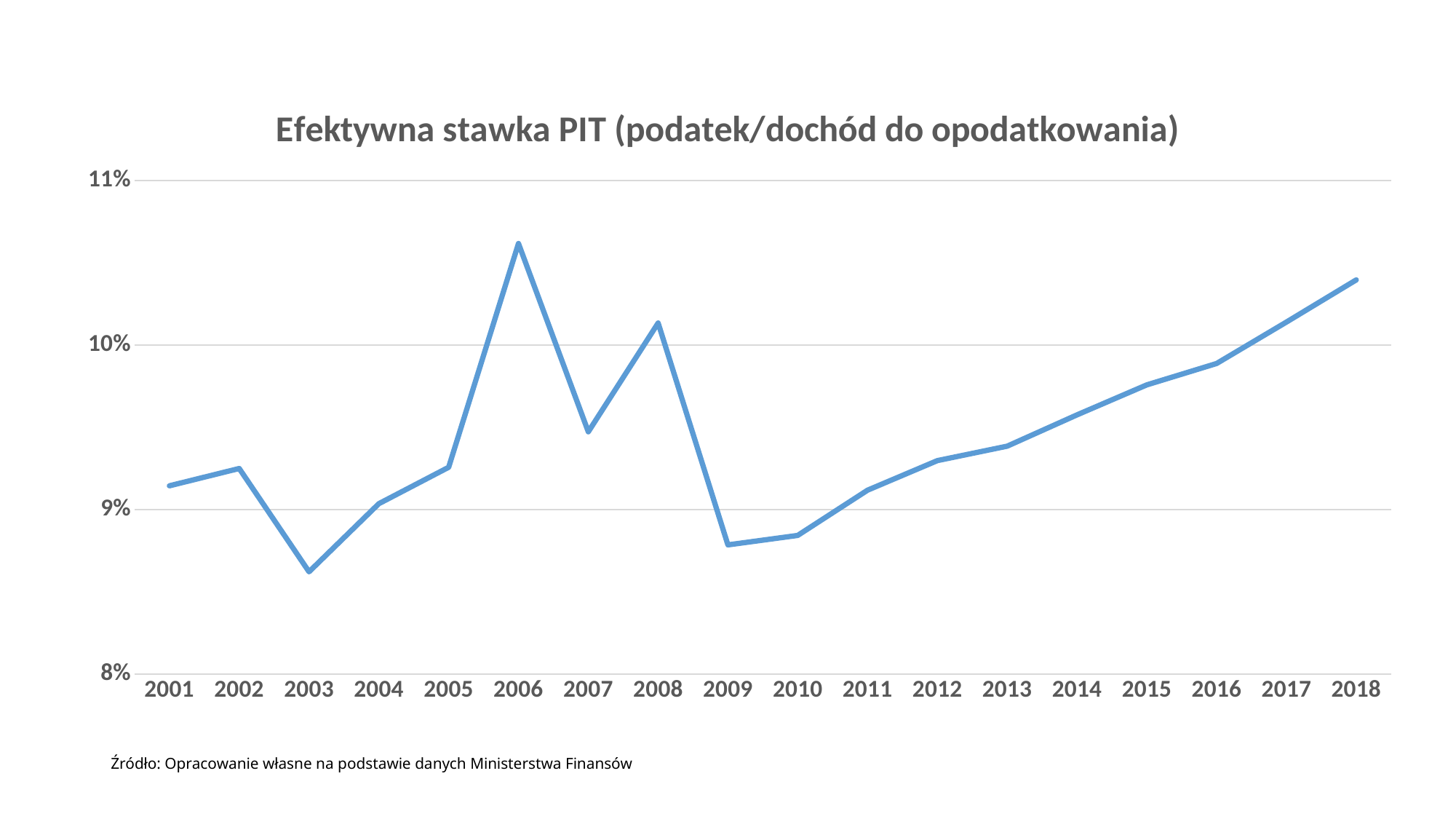
Which year has the higher value, 2006 or 2008? 2006 How many years are plotted on the x axis? 18 Is the value for 2009 greater or less than 9%? less In which year is the effective PIT rate highest? 2006 Is the value for 2006 greater or less than 10%? greater What is the title of the chart? Efektywna stawka PIT (podatek/dochód do opodatkowania) Does the effective PIT rate rise or fall from 2009 to 2018? rise Is the value for 2003 greater or less than 9%? less In which year is the effective PIT rate lowest? 2003 What kind of chart is shown on the slide? line chart